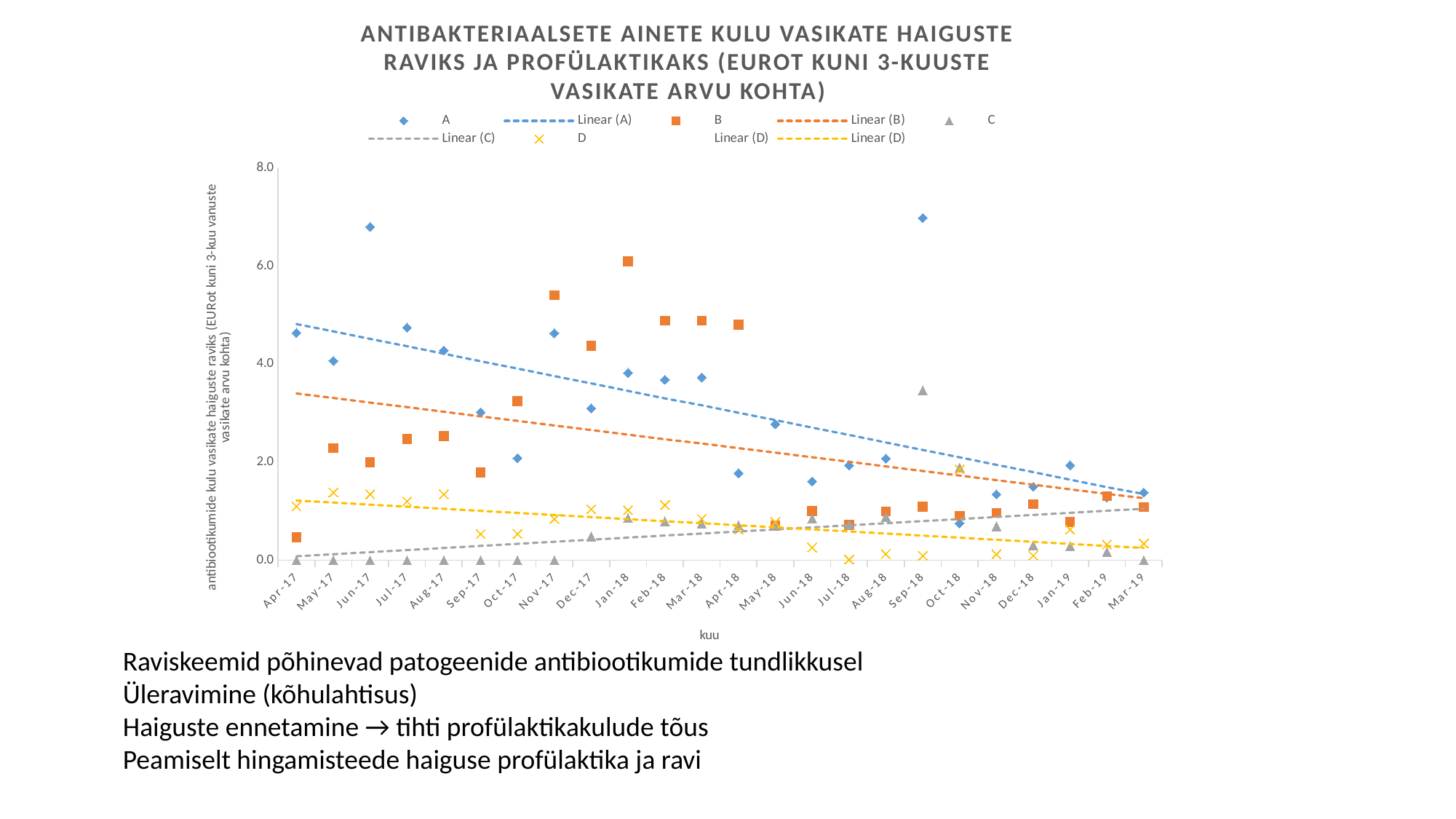
Is the value for series C in Sep-18 greater or less than 2.0? greater How many months are shown along the x axis of the chart? 24 Does the Linear (A) trendline rise or fall from left to right? fall Is the value for series B in Jan-18 greater or less than 4.0? greater What is the label of the x axis? kuu Is the value for series A in Sep-18 greater or less than 6.0? greater What is the first month shown on the x axis? Apr-17 In which month does series C reach its highest value? Sep-18 What kind of chart is shown on the slide? scatter chart In which month does series B reach its highest value? Jan-18